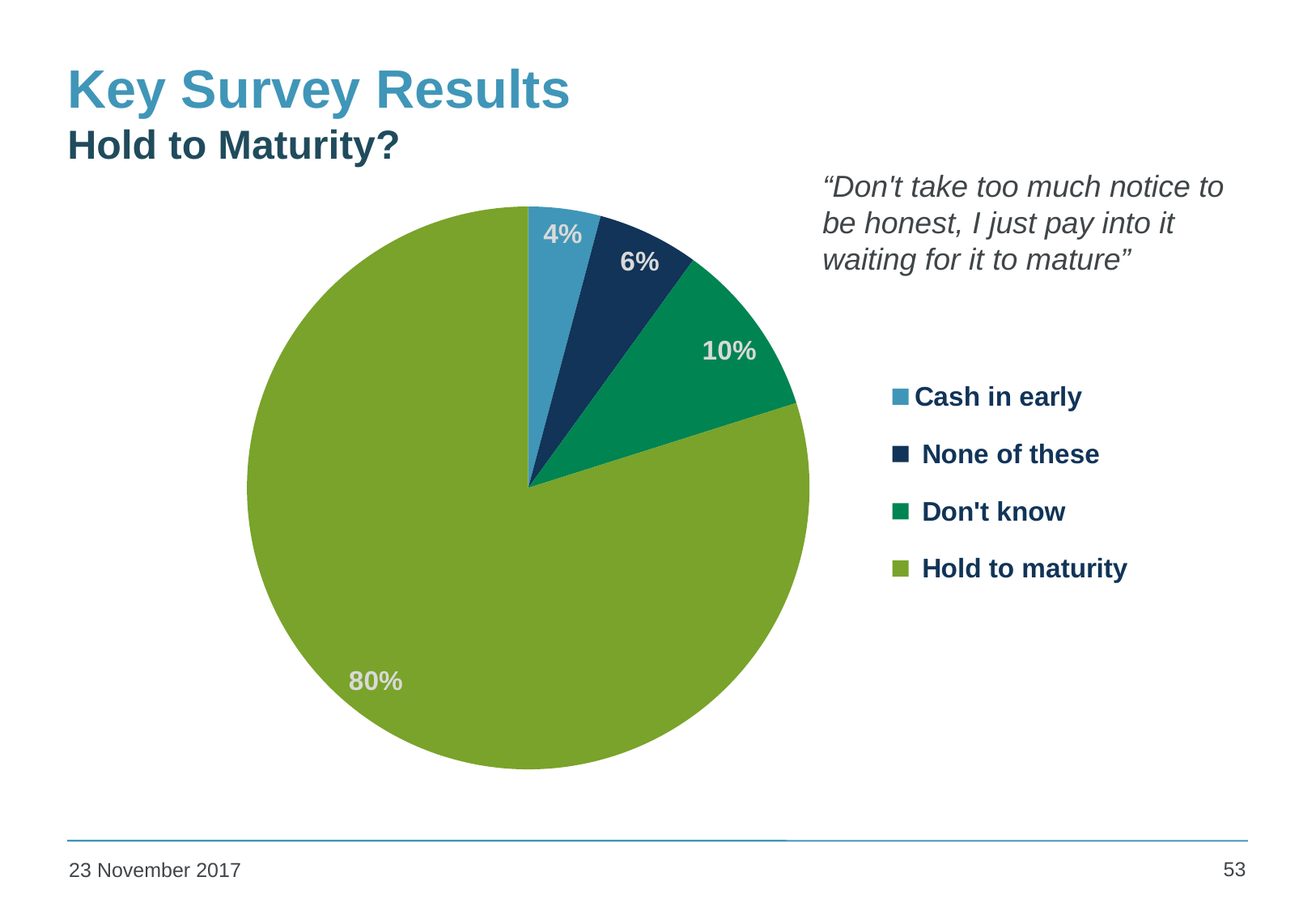
What kind of chart is shown on the slide? pie chart Which category has the largest slice of the pie? Hold to maturity What share of the pie is labelled 'Cash in early'? 4% Which category has the smallest slice of the pie? Cash in early Which is larger, the share for 'Don't know' or the share for 'None of these'? Don't know What share of the pie is labelled 'None of these'? 6% What is the difference in percentage points between 'Hold to maturity' and 'Don't know'? 70 How many categories does the legend list? 4 What is the difference in percentage points between 'None of these' and 'Cash in early'? 2 What share of the pie is labelled 'Don't know'? 10% What colour is the 'Hold to maturity' slice? green